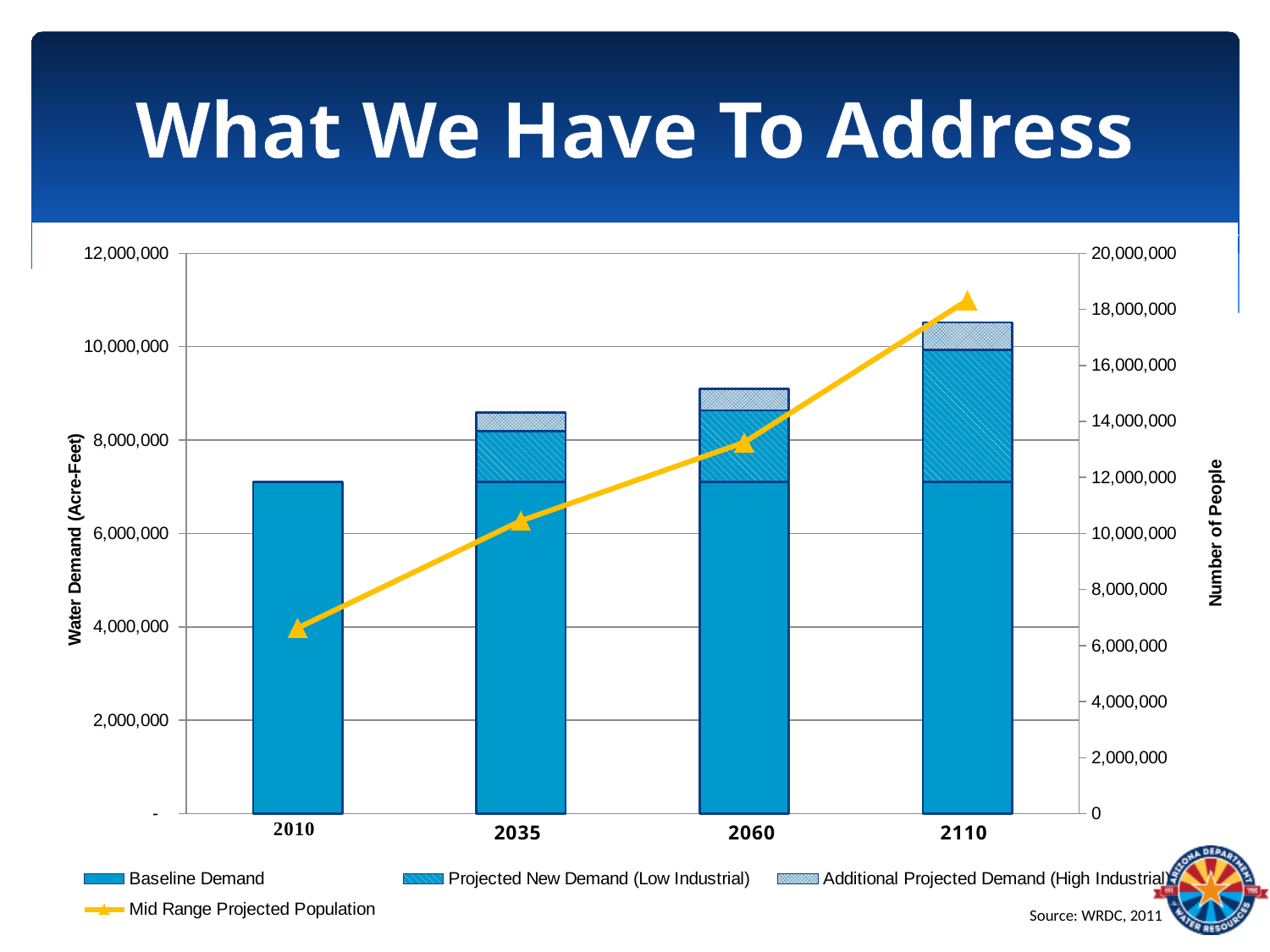
Which year has the tallest stacked bar for water demand? 2110 What is the title of the right-hand vertical axis of the chart? Number of People How many series does the chart's legend list? 4 What kind of chart is shown on the slide? A combination chart of stacked bars and a line Is the total water demand bar for 2110 greater or less than 10,000,000 acre-feet? greater How many years are shown on the x axis of the chart? 4 Which year has the shortest stacked bar for water demand? 2010 Does the Mid Range Projected Population line rise or fall from 2010 to 2110? rise Is the total water demand bar for 2010 greater or less than 8,000,000 acre-feet? less Which year has the larger total water demand bar, 2035 or 2060? 2060 Is the Mid Range Projected Population for 2110 greater or less than 16,000,000 people? greater